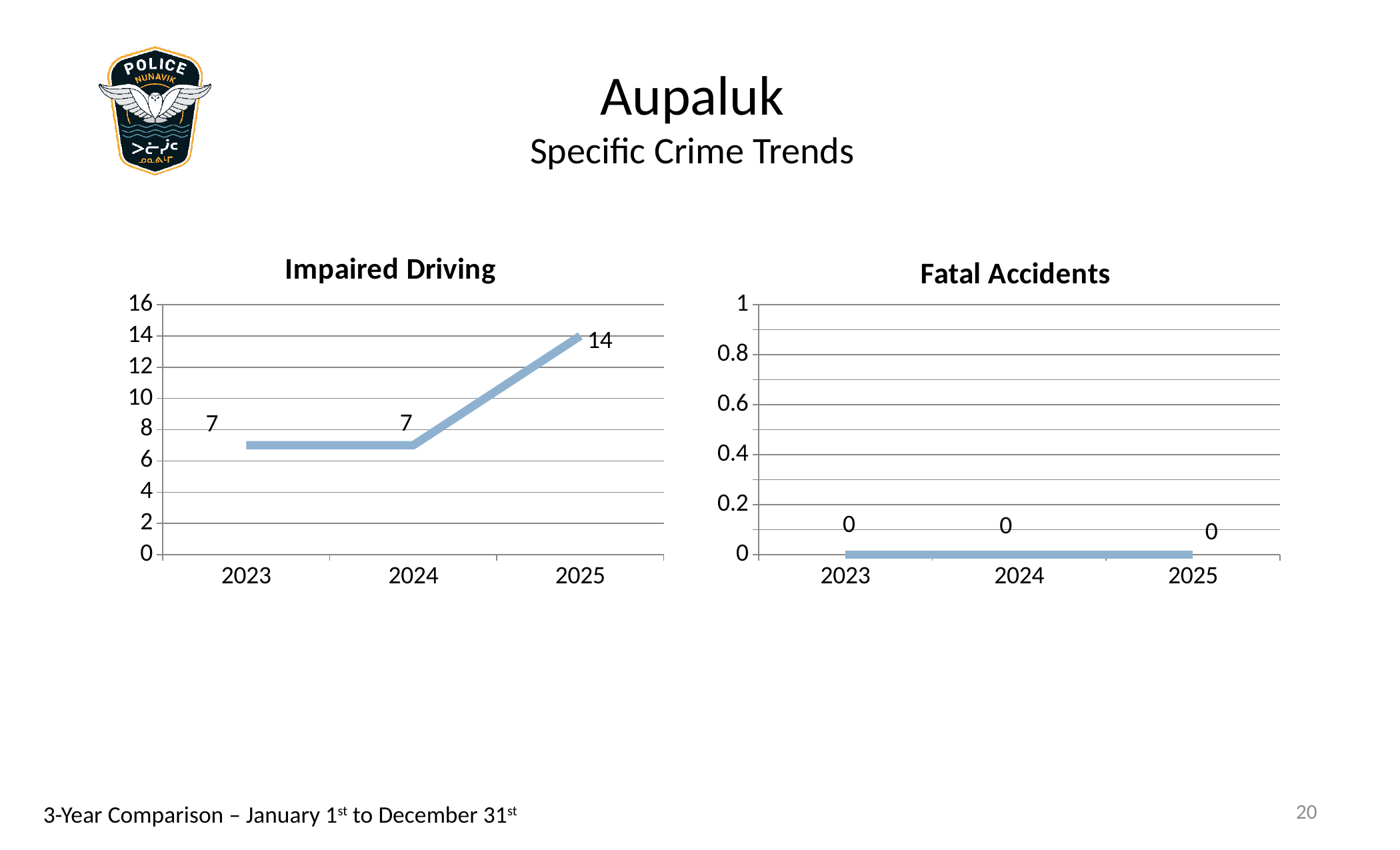
In the Fatal Accidents chart, what is the value for 2024? 0 In the Impaired Driving chart, do the values rise or fall from 2024 to 2025? Rise What kind of chart is the Impaired Driving chart? Line chart In the Impaired Driving chart, what is the difference between the 2025 and 2024 values? 7 In the Fatal Accidents chart, what is the highest value shown on the y axis? 1 In the Impaired Driving chart, what is the value for 2025? 14 In the Impaired Driving chart, which year has the highest value? 2025 In the Impaired Driving chart, is the value for 2025 greater or less than 10? greater In the Impaired Driving chart, how many years are plotted? 3 In the Impaired Driving chart, what is the value for 2023? 7 What is the title of the chart on the right side of the slide? Fatal Accidents In the Impaired Driving chart, is the value for 2025 larger than the value for 2023? Yes